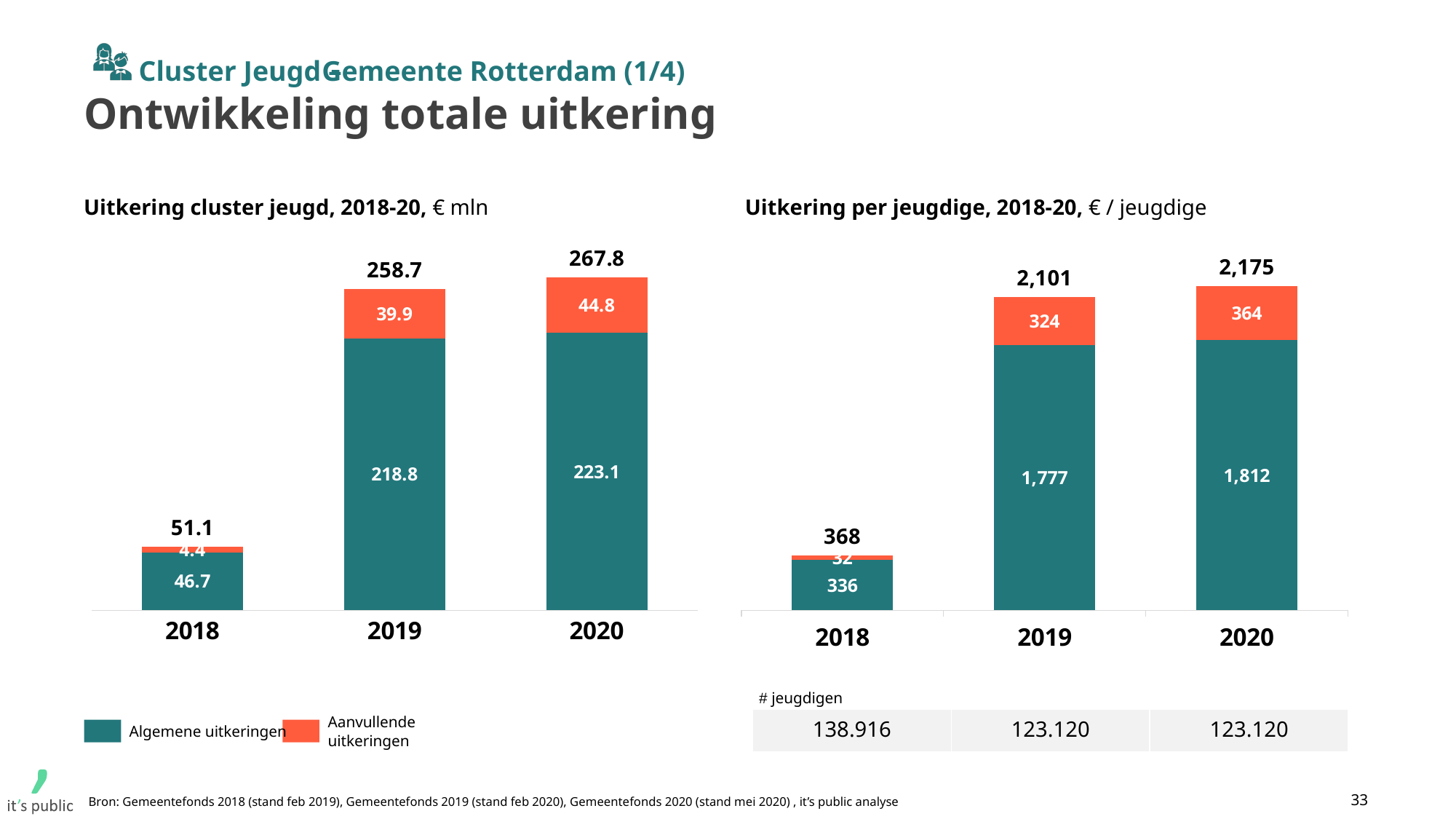
What kind of chart is 'Uitkering cluster jeugd, 2018-20'? Stacked bar chart In the chart 'Uitkering cluster jeugd, 2018-20', what is the value of Aanvullende uitkeringen for 2020? 44.8 In the chart 'Uitkering per jeugdige, 2018-20', what is the total of the stacked bar for 2019? 2,101 In the chart 'Uitkering per jeugdige, 2018-20', which year has the lowest total? 2018 In the chart 'Uitkering per jeugdige, 2018-20', what is the value of Algemene uitkeringen for 2020? 1,812 In the chart 'Uitkering cluster jeugd, 2018-20', what is the total of the stacked bar for 2018? 51.1 In the chart 'Uitkering per jeugdige, 2018-20', is the Aanvullende uitkeringen value for 2020 larger or smaller than for 2019? larger In the chart 'Uitkering per jeugdige, 2018-20', what is the value of Aanvullende uitkeringen for 2019? 324 How many series does the legend on the left chart list? 2 In the chart 'Uitkering cluster jeugd, 2018-20', what is the difference between the total for 2020 and the total for 2019? 9.1 In the chart 'Uitkering cluster jeugd, 2018-20', what is the value of Algemene uitkeringen for 2019? 218.8 In the chart 'Uitkering cluster jeugd, 2018-20', which year has the highest total uitkering? 2020